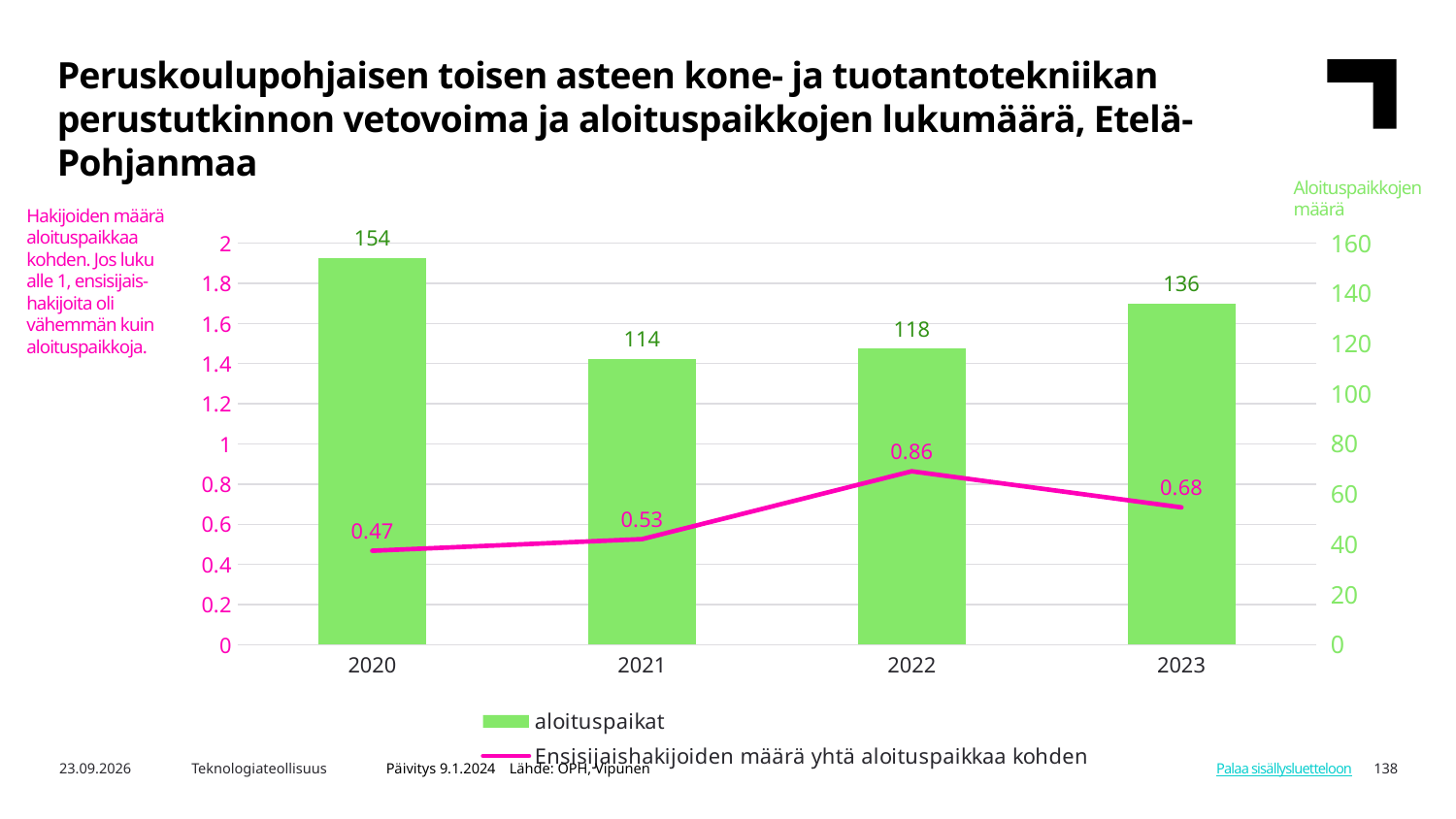
Which year has the highest value for aloituspaikat? 2020 How many series does the legend list? 2 How many years are shown on the x axis? 4 What is the value of Ensisijaishakijoiden määrä yhtä aloituspaikkaa kohden for 2022? 0.86 Does the Ensisijaishakijoiden määrä yhtä aloituspaikkaa kohden line rise or fall from 2020 to 2022? rise Which year has the lowest value for Ensisijaishakijoiden määrä yhtä aloituspaikkaa kohden? 2020 What is the value of aloituspaikat for 2020? 154 What is the difference between the aloituspaikat values for 2020 and 2021? 40 What is the value of aloituspaikat for 2023? 136 Is the value of Ensisijaishakijoiden määrä yhtä aloituspaikkaa kohden for 2023 greater or less than 1? less Which year has a larger aloituspaikat value, 2021 or 2022? 2022 What colour are the aloituspaikat bars? green